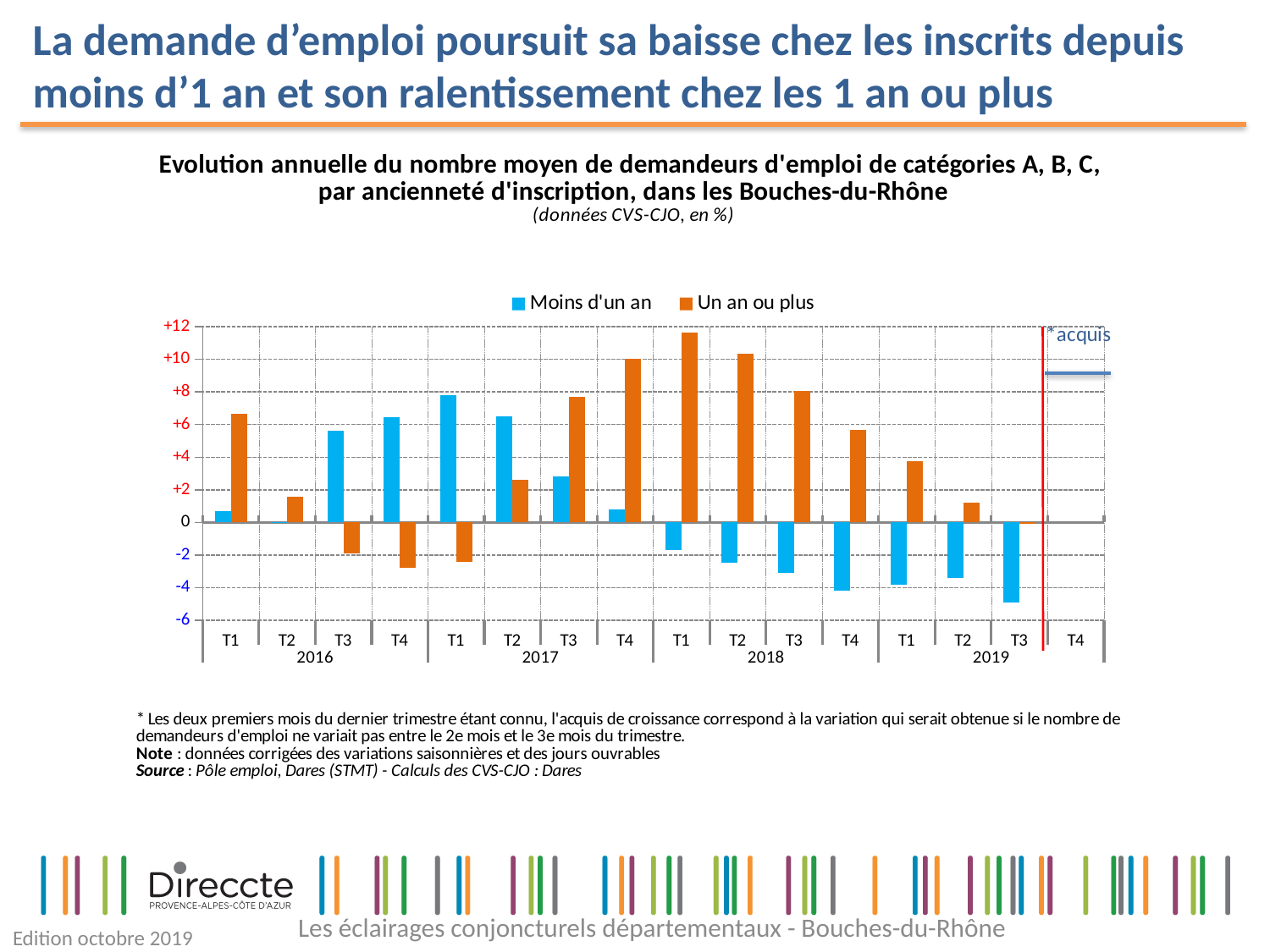
What are the two series named in the legend? Moins d'un an; Un an ou plus In which quarter does the 'Moins d'un an' series reach its lowest value? T3 2019 Is the value for 'Un an ou plus' in T4 2017 greater or less than +8? greater In T3 2017, which series has the larger value, 'Moins d'un an' or 'Un an ou plus'? Un an ou plus In which quarter does the 'Un an ou plus' series reach its highest value? T1 2018 Is the value for 'Un an ou plus' in T1 2018 greater or less than +10? greater From T1 2018 to T3 2019, do the values of the 'Un an ou plus' series rise or fall? fall How many quarters are labelled along the x axis? 16 In which quarter does the 'Moins d'un an' series reach its highest value? T1 2017 How many series does the legend list? 2 What kind of chart is shown on the slide? bar chart Is the value for 'Moins d'un an' in T3 2019 greater or less than -4? less